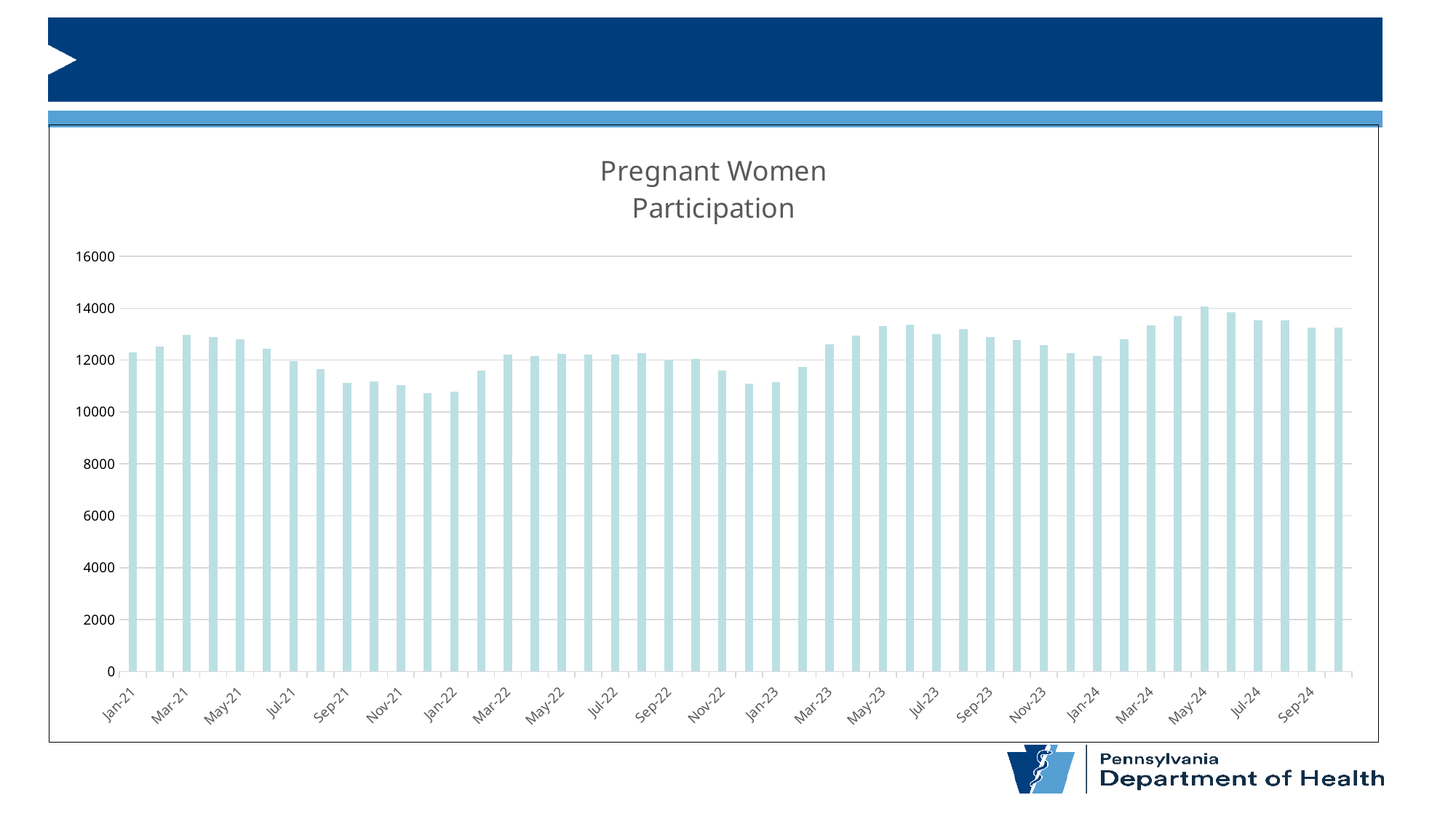
Is the value for Sep-24 greater or less than 14000? less Is the value for Jan-23 greater or less than 12000? less Which month has the highest bar in the chart? May-24 What is the title of the chart? Pregnant Women Participation Which is larger, the value for Mar-21 or the value for Sep-21? Mar-21 Is the value for Sep-21 greater or less than 12000? less Do the values rise or fall from Jan-23 to May-23? rise Which is larger, the value for Jan-23 or the value for May-23? May-23 What kind of chart is shown on the slide? bar chart